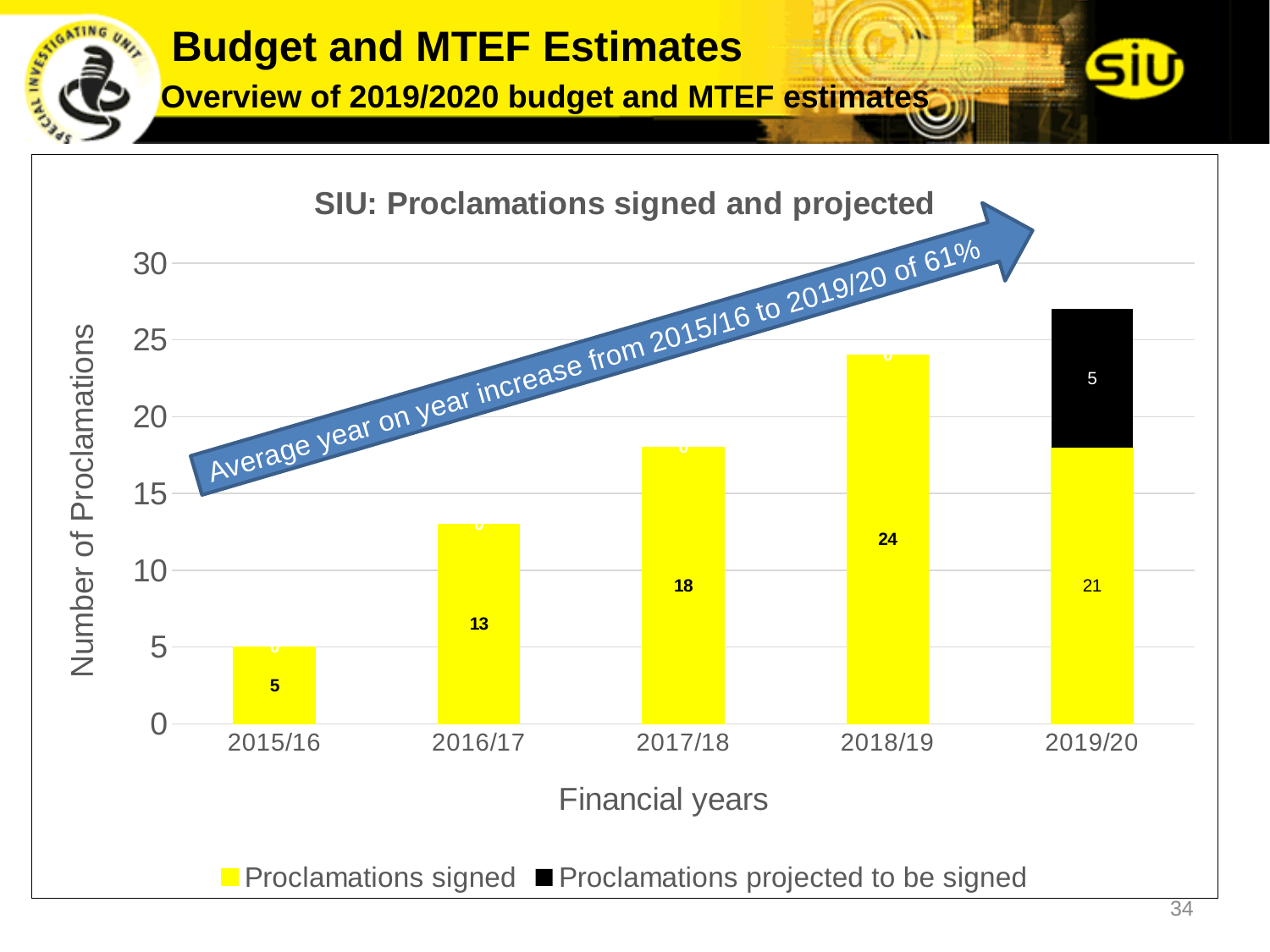
Do the proclamations signed rise or fall from 2015/16 to 2018/19? Rise What is the value for Proclamations signed in 2018/19? 24 Which financial year has the lowest number of proclamations signed? 2015/16 How many proclamations were signed in 2015/16? 5 Which year had more proclamations signed, 2016/17 or 2017/18? 2017/18 How many financial years are shown on the x axis? 5 How many series does the legend list? 2 What is the value for Proclamations signed in 2017/18? 18 What kind of chart is shown on the slide? Bar chart What is the difference between proclamations signed in 2018/19 and 2015/16? 19 How many proclamations are projected to be signed in 2019/20? 5 Which financial year has the highest number of proclamations signed? 2018/19